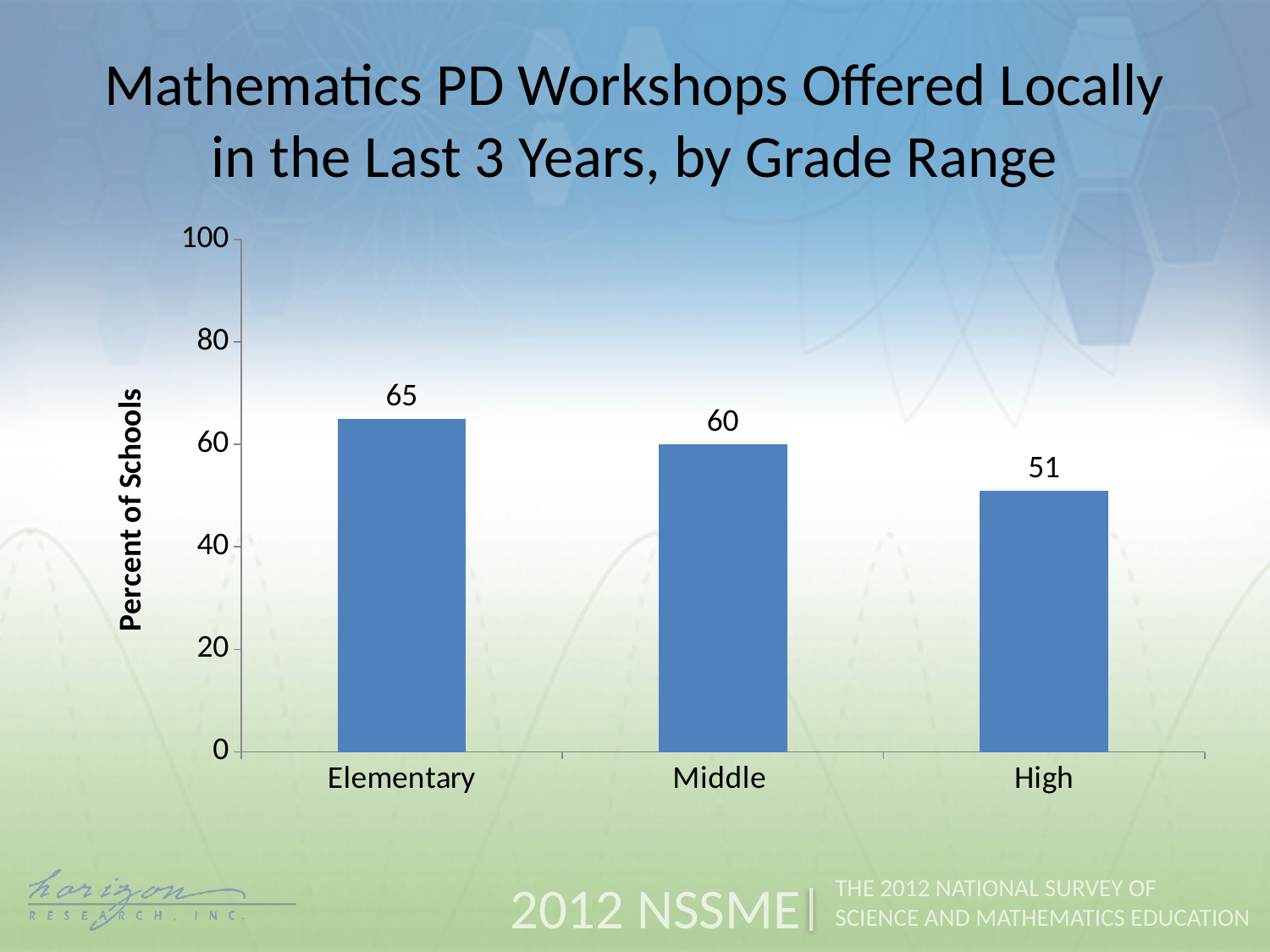
What is the difference between the values for Elementary and High? 14 What is the value for High? 51 What is the difference between the values for Middle and High? 9 Is the value for High greater or less than 60? less How many grade ranges are shown on the x axis? 3 What is the label of the y axis? Percent of Schools Which grade range has the highest percent of schools? Elementary Which grade range has the lowest percent of schools? High What kind of chart is shown on the slide? bar chart What is the value for Elementary? 65 What is the value for Middle? 60 Which is larger, the value for Middle or the value for High? Middle